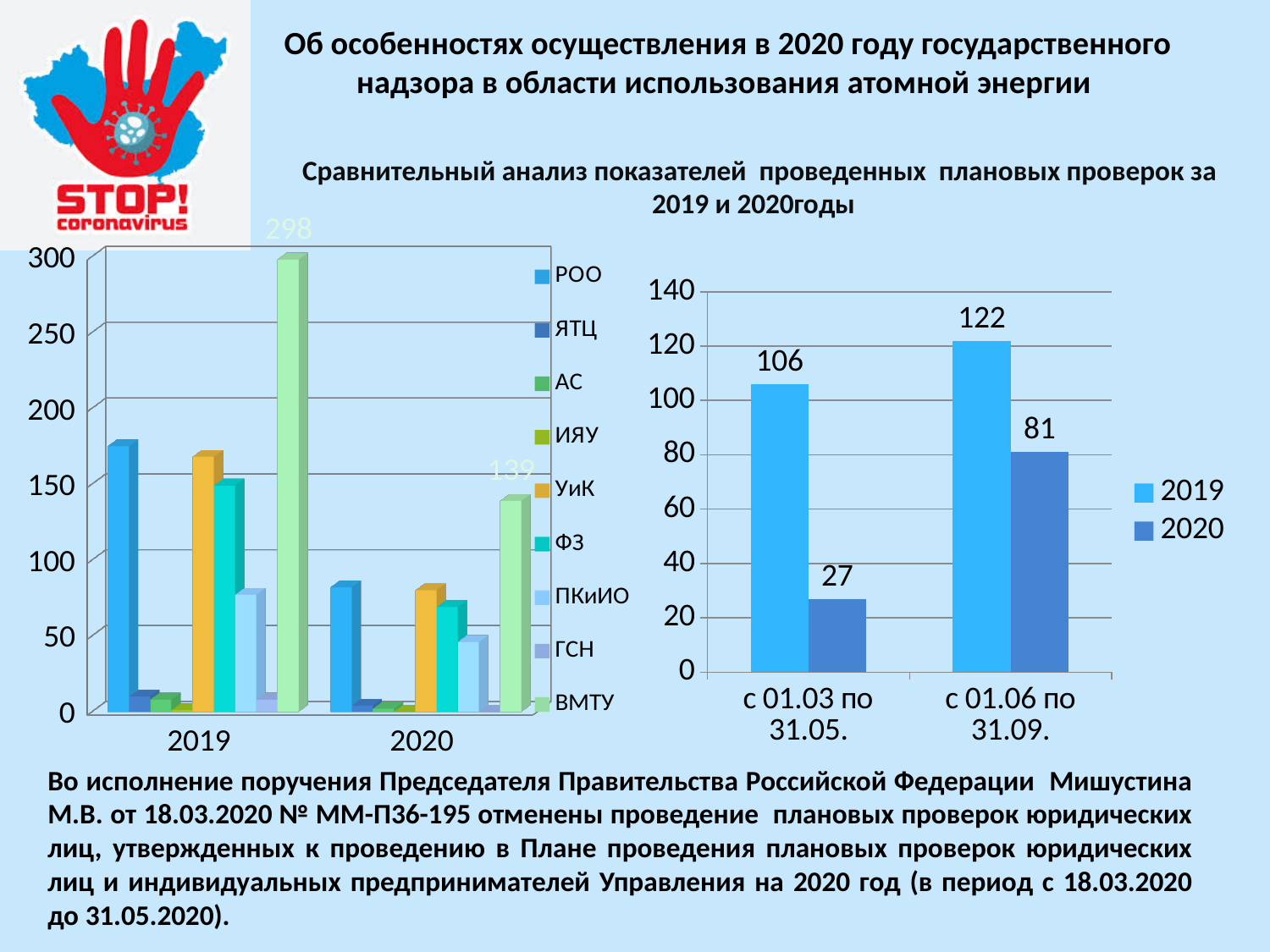
In the right chart, what is the difference between the 2019 and 2020 values for the period с 01.03 по 31.05.? 79 In the right chart, which is larger: the 2020 value for с 01.03 по 31.05. or the 2020 value for с 01.06 по 31.09.? с 01.06 по 31.09. In the left chart, what is the difference between the ВМТУ values for 2019 and 2020? 159 In the left chart, what is the value for ВМТУ in 2019? 298 In the right chart, what is the value for 2019 in the period с 01.03 по 31.05.? 106 In the left chart, is the value for РОО in 2019 greater or less than 150? greater How many series does the legend of the left chart list? 9 In the left chart, what is the value for ВМТУ in 2020? 139 In the right chart, which bar has the lowest value? 2020, с 01.03 по 31.05. How many series does the legend of the right chart list? 2 What kind of chart is the left chart? bar chart In the right chart, what is the value for 2020 in the period с 01.06 по 31.09.? 81